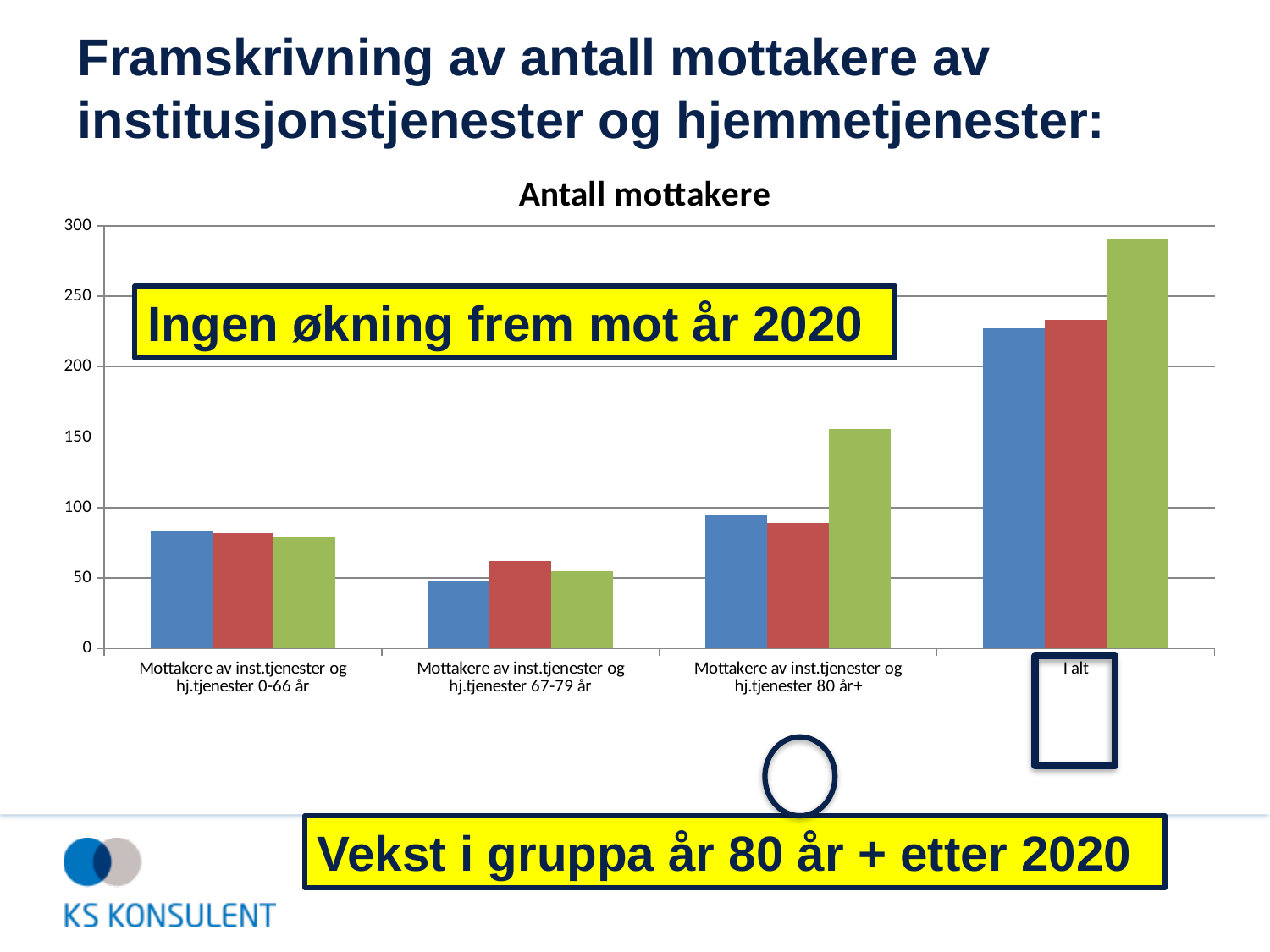
Which category has the tallest bars in the chart? I alt In the 'I alt' category, do the bars rise or fall from left to right? rise Which category has the shortest bars in the chart? Mottakere av inst.tjenester og hj.tjenester 67-79 år How many bars are plotted for each category in the chart? 3 Is the green bar for 'Mottakere av inst.tjenester og hj.tjenester 80 år+' greater or less than 100? greater Is the blue bar for 'Mottakere av inst.tjenester og hj.tjenester 67-79 år' greater or less than 100? less What kind of chart is shown on the slide? bar chart Is the blue bar for 'Mottakere av inst.tjenester og hj.tjenester 0-66 år' greater or less than 100? less How many categories are shown on the x axis of the chart? 4 In the 'I alt' category, which is larger: the blue bar or the green bar? the green bar What is the title of the chart? Antall mottakere